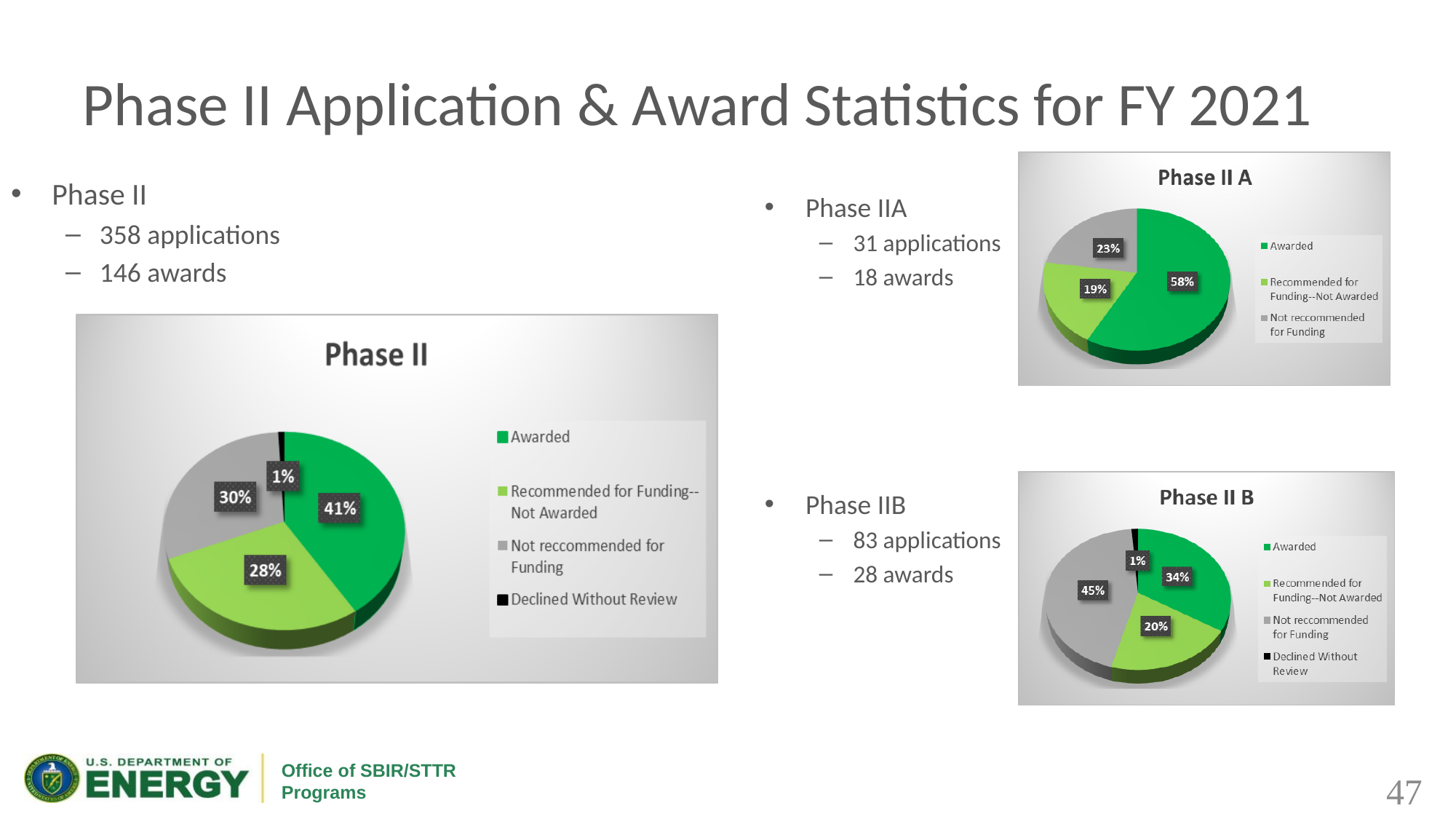
In the Phase II pie chart, what share was Not recommended for Funding? 30% What type of chart is the Phase II B chart? Pie chart In the Phase II pie chart, which category has the smallest share? Declined Without Review In the Phase II B pie chart, which is larger: Awarded or Recommended for Funding--Not Awarded? Awarded In the Phase II pie chart, what is the difference between the Awarded share and the Recommended for Funding--Not Awarded share? 13% In the Phase II B pie chart, what is the difference between the Not recommended for Funding share and the Awarded share? 11% In the Phase II pie chart, what share of applications were Awarded? 41% In the Phase II A pie chart, what share of applications were Awarded? 58% In the Phase II B pie chart, what share was Not recommended for Funding? 45% How many categories does the legend of the Phase II A pie chart list? 3 How many categories does the legend of the Phase II B pie chart list? 4 In the Phase II A pie chart, which category has the largest share? Awarded